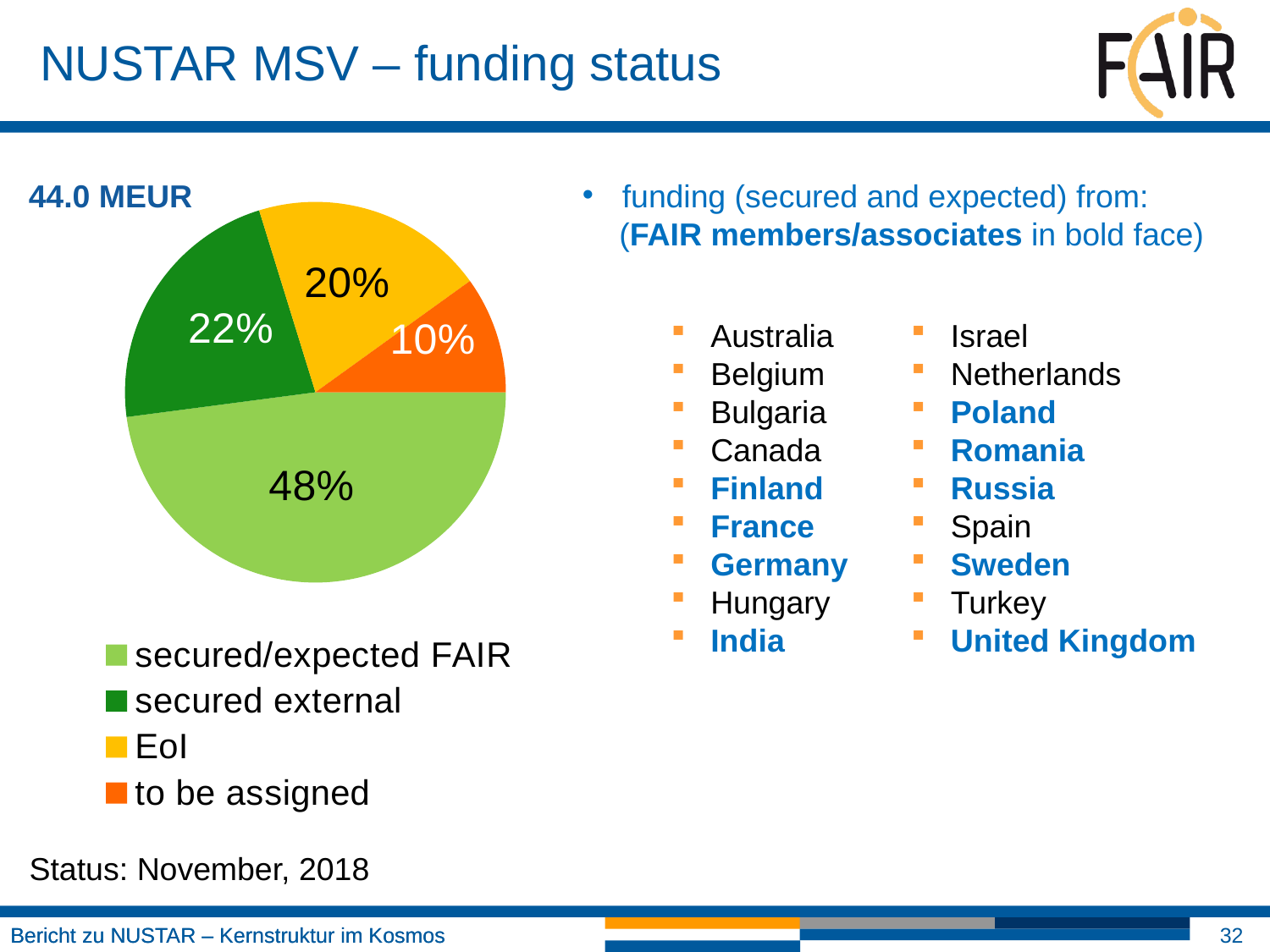
What share of the pie is labelled 'secured external'? 22% What share of the pie is labelled 'secured/expected FAIR'? 48% What colour is the 'EoI' slice in the pie chart? yellow What share of the pie is labelled 'EoI'? 20% Which category has the largest slice of the pie? secured/expected FAIR What kind of chart is shown on the slide? pie chart How many slices does the pie chart have? 4 Which is larger, the 'secured external' slice or the 'EoI' slice? secured external Which category has the smallest slice of the pie? to be assigned What is the difference in percentage points between the 'secured/expected FAIR' slice and the 'secured external' slice? 26 What total amount is stated above the pie chart? 44.0 MEUR